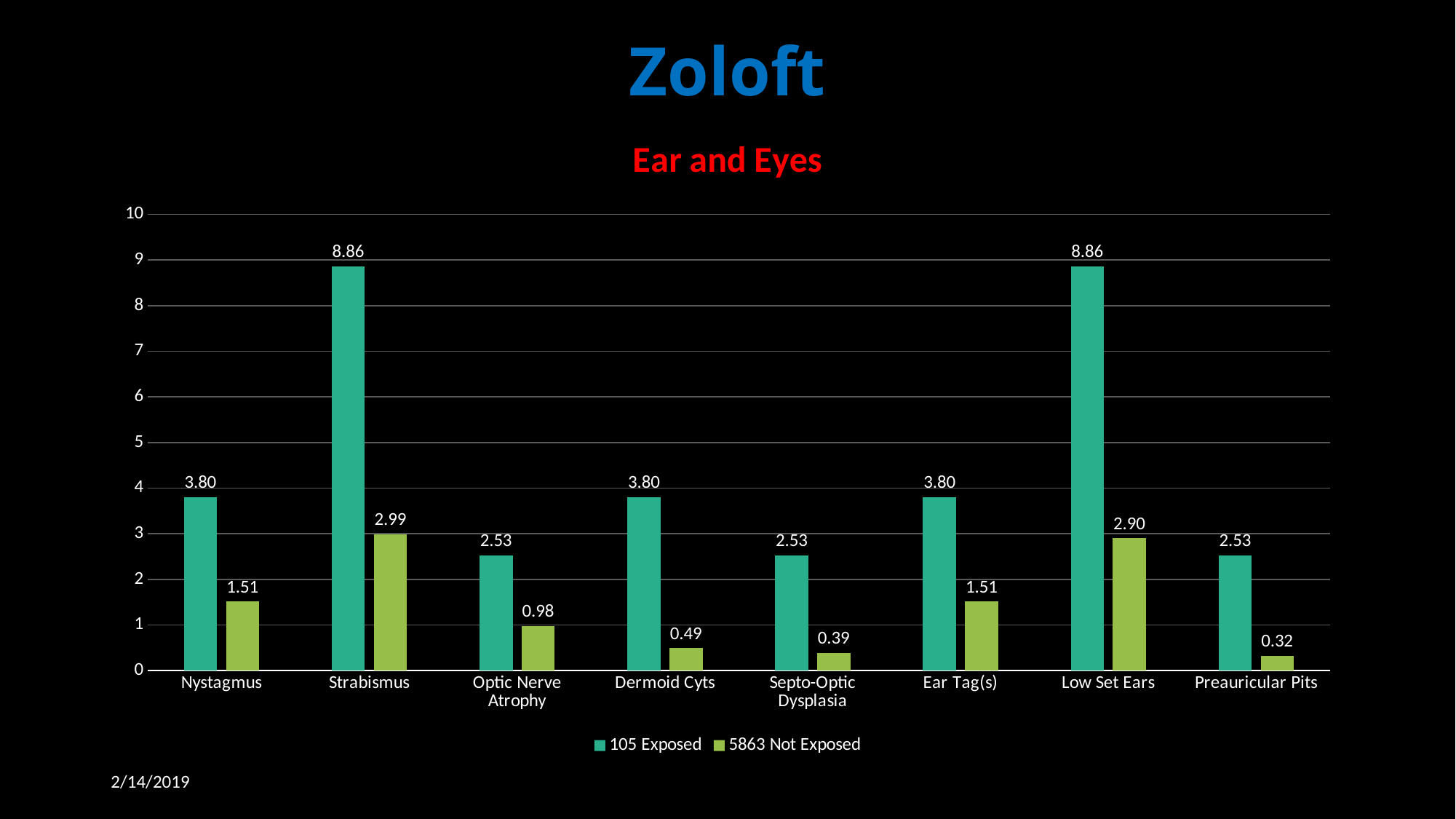
Is the 105 Exposed value for Low Set Ears greater or less than 8? greater What is the value for Low Set Ears in the 5863 Not Exposed series? 2.90 Which category has the lowest value in the 5863 Not Exposed series? Preauricular Pits Which category has the highest value in the 5863 Not Exposed series? Strabismus How many categories are shown on the x axis? 8 How many series does the legend list? 2 What is the chart's title? Ear and Eyes What is the value for Optic Nerve Atrophy in the 5863 Not Exposed series? 0.98 Which is larger: the 5863 Not Exposed value for Nystagmus or for Septo-Optic Dysplasia? Nystagmus What kind of chart is shown on the slide? Bar chart What is the difference between the 105 Exposed and 5863 Not Exposed values for Dermoid Cyts? 3.31 What is the value for Strabismus in the 105 Exposed series? 8.86